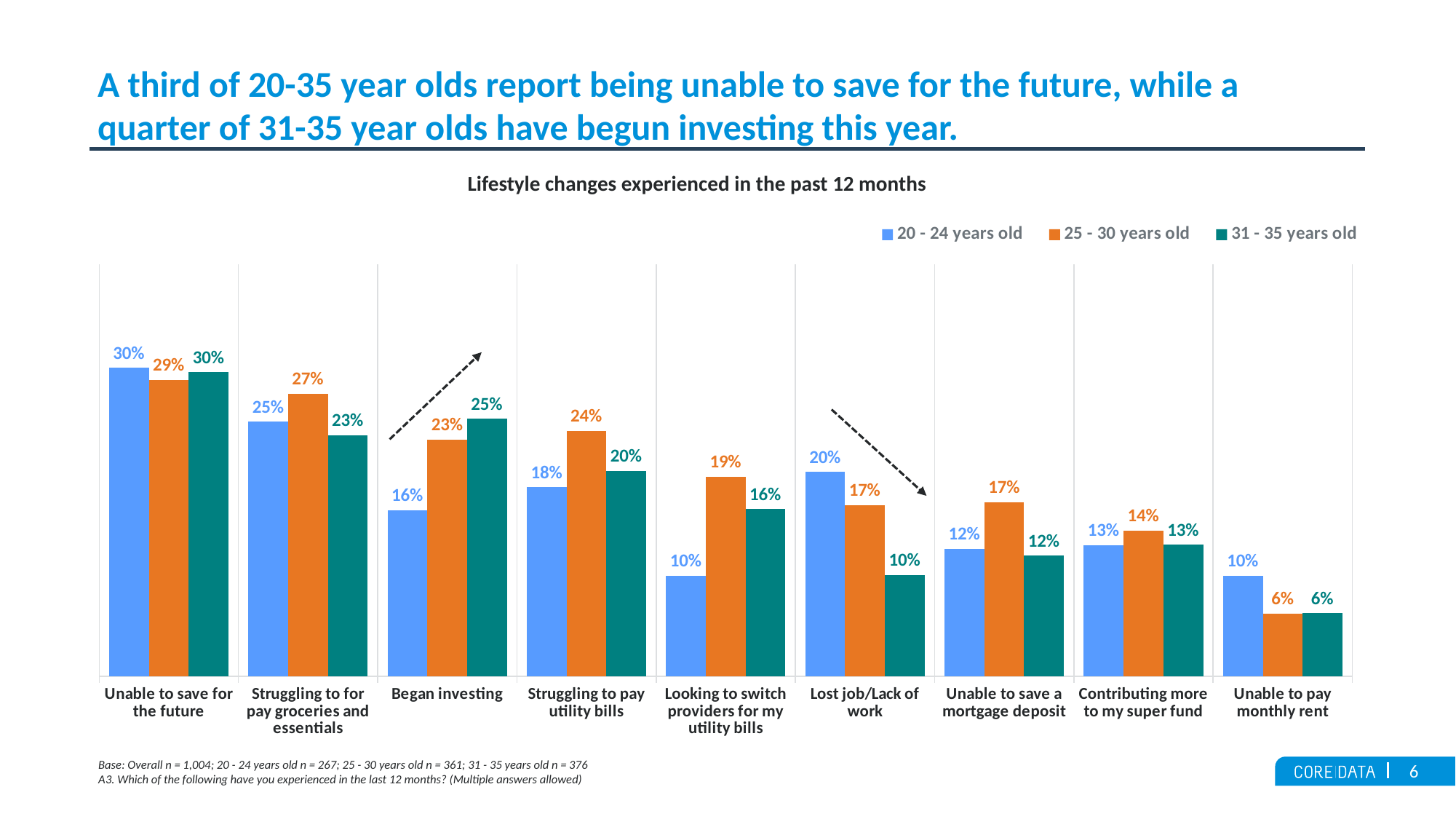
What is the title of the chart? Lifestyle changes experienced in the past 12 months What percentage of 25 - 30 year olds are struggling to pay utility bills? 24% For 'Looking to switch providers for my utility bills', which age group has the larger value: 20 - 24 years old or 25 - 30 years old? 25 - 30 years old Which category has the lowest value for the 20 - 24 years old series? Looking to switch providers for my utility bills and Unable to pay monthly rent (both 10%) How many series does the legend list? 3 What percentage of 20 - 24 year olds report being unable to save for the future? 30% What is the value for 31 - 35 years old in the 'Began investing' category? 25% Which category has the highest value for the 25 - 30 years old series? Unable to save for the future What is the value for 25 - 30 years old in the 'Unable to pay monthly rent' category? 6% How many lifestyle change categories are shown on the x axis? 9 What is the difference between the 20 - 24 years old and 31 - 35 years old values for 'Lost job/Lack of work'? 10% What kind of chart is shown on the slide? Bar chart